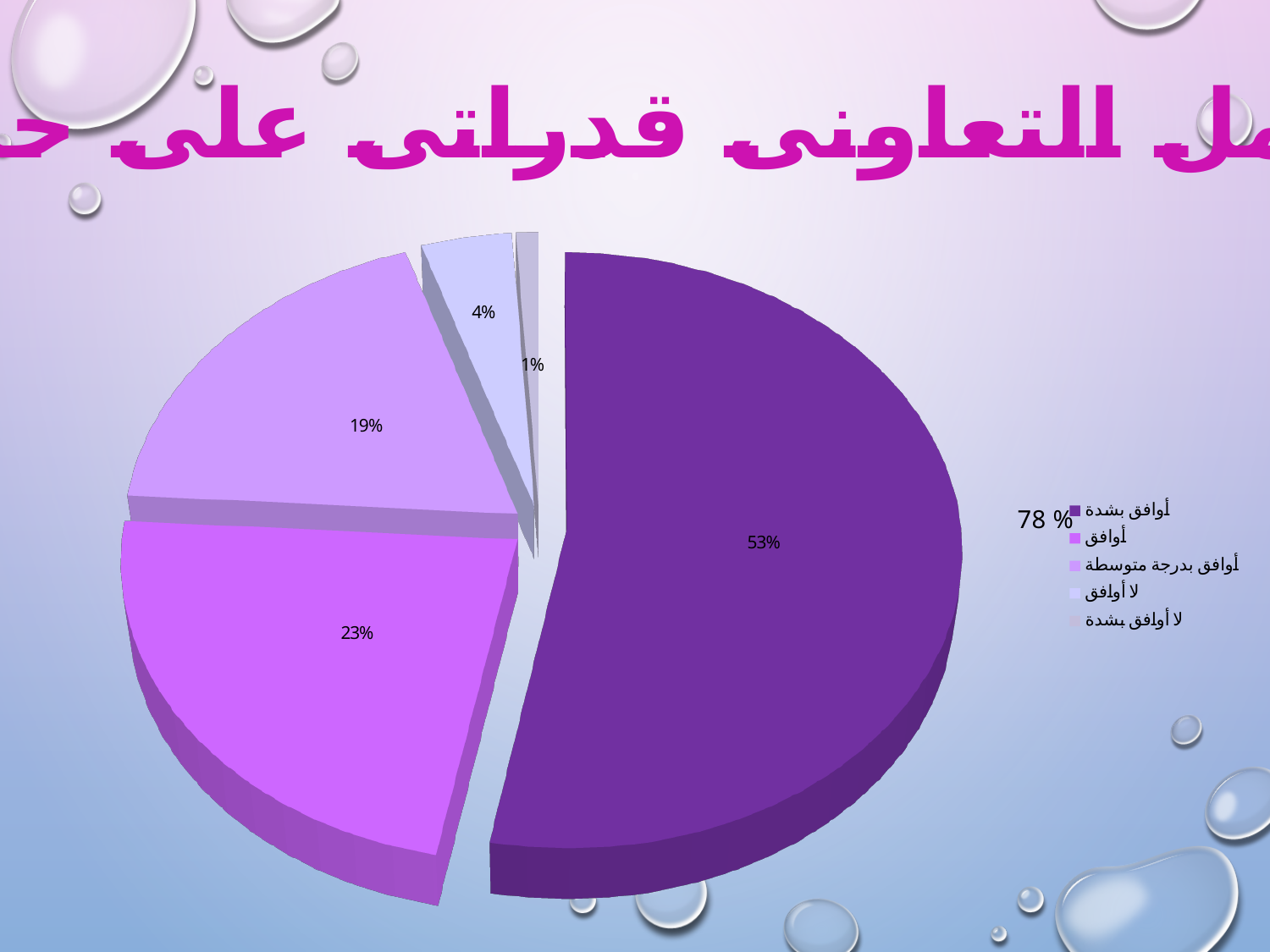
What percentage is shown for the slice labelled أوافق? 23% How many entries does the legend list? 5 What percentage is shown for the slice labelled أوافق بدرجة متوسطة? 19% How many slices does the pie chart have? 5 Which category has the smallest slice of the pie? لا أوافق بشدة What percentage is shown for the slice labelled لا أوافق? 4% What is the difference between the أوافق بشدة slice and the أوافق slice? 30% Which category has the largest slice of the pie? أوافق بشدة What kind of chart is shown on the slide? pie chart Which is larger, the slice for أوافق or the slice for أوافق بدرجة متوسطة? أوافق What percentage is shown for the slice labelled لا أوافق بشدة? 1% What percentage is shown for the slice labelled أوافق بشدة? 53%